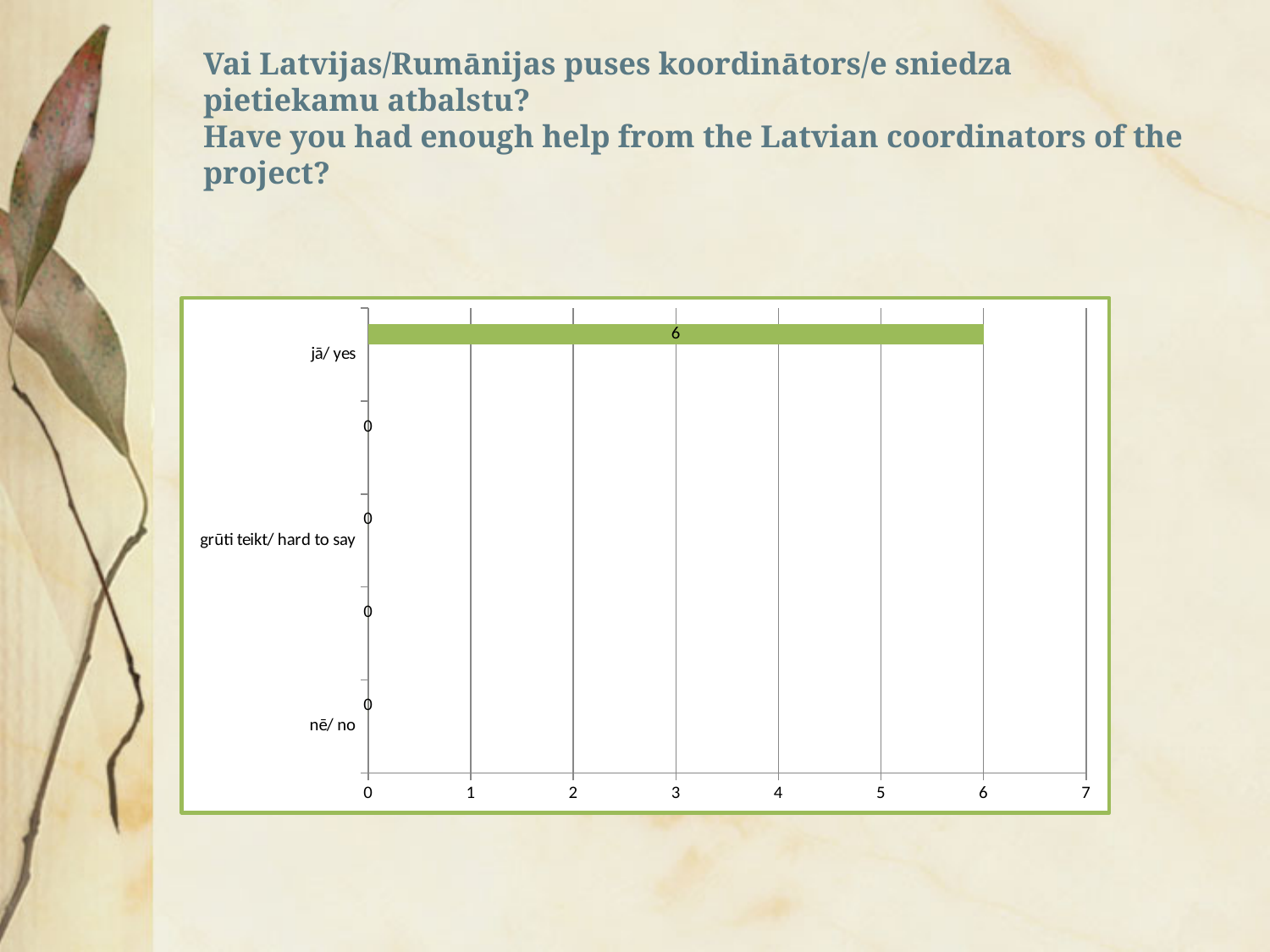
What is the value for "grūti teikt/ hard to say"? 0 What colour is the bar for "jā/ yes"? green Which is larger, the value for "jā/ yes" or the value for "grūti teikt/ hard to say"? jā/ yes What is the difference between the values for "jā/ yes" and "nē/ no"? 6 Which category has the highest value? jā/ yes What is the value for "jā/ yes"? 6 What is the value for "nē/ no"? 0 Is the value for "jā/ yes" greater or less than 5? greater How many category labels are shown on the vertical axis? 3 What kind of chart is shown on the slide? bar chart What is the highest value shown on the horizontal axis? 7